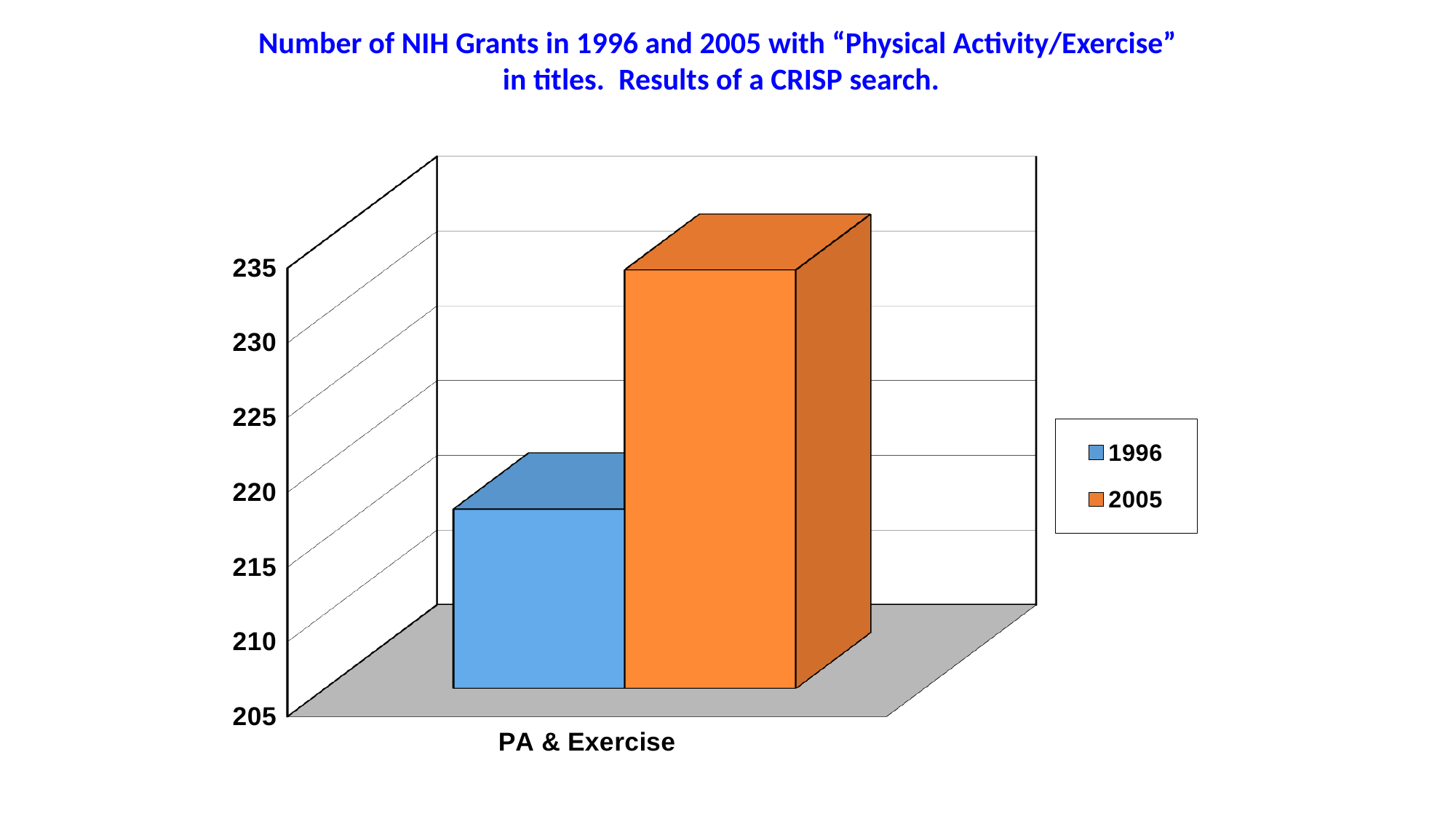
Is the value for 1996 greater or less than 210? greater What is the label of the category on the x axis? PA & Exercise How many series does the legend list? 2 Which year has the highest number of grants for PA & Exercise? 2005 Is the value for 1996 greater or less than 225? less Which series has the higher value for PA & Exercise, 1996 or 2005? 2005 Which colour represents the 2005 series in the legend? Orange Is the value for 2005 greater or less than 225? greater How many categories are shown on the x axis? 1 Which year has the lowest number of grants for PA & Exercise? 1996 What kind of chart is shown on the slide? Bar chart